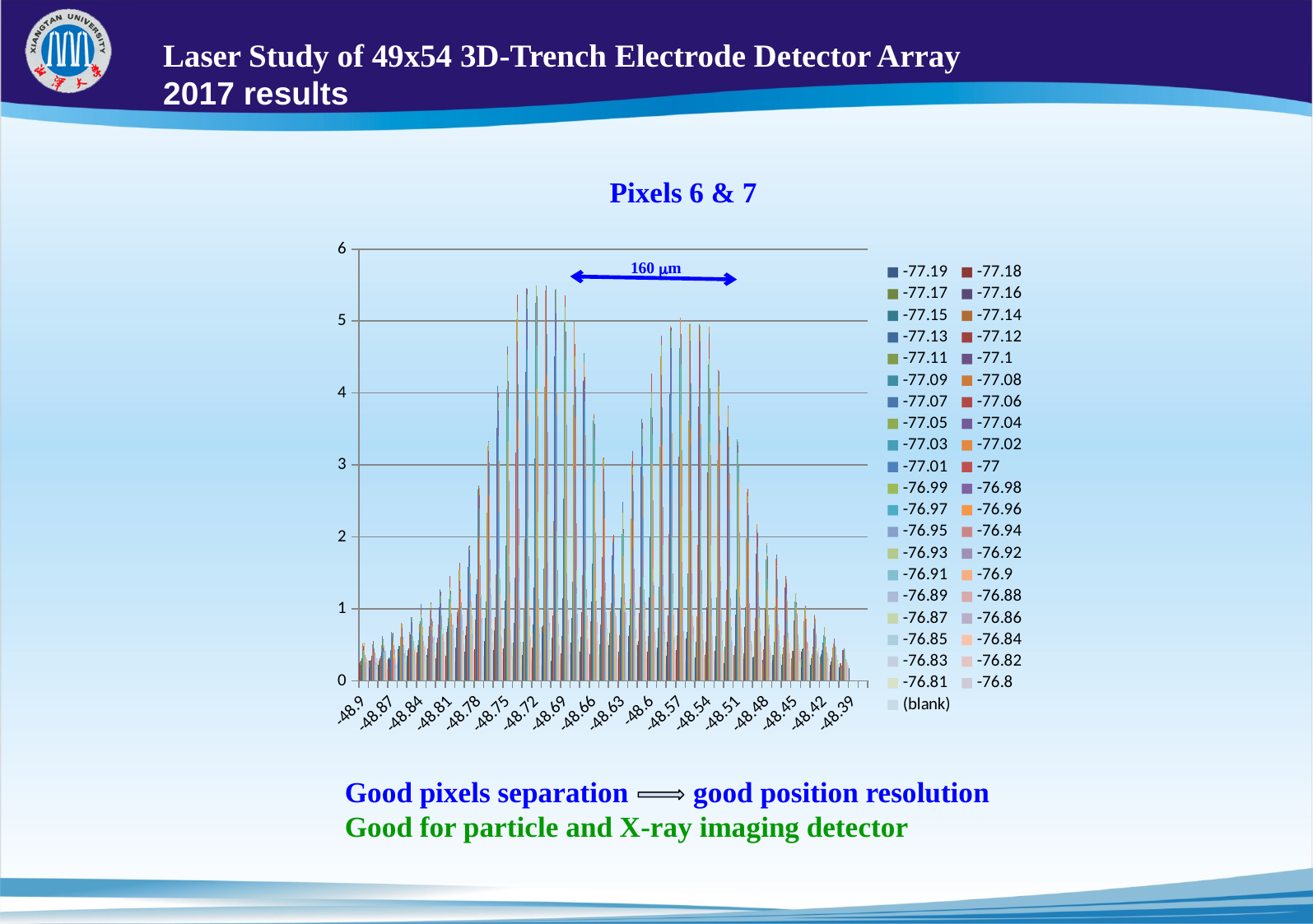
Are the tallest bars near the -48.72 label greater or less than 5? greater Are the bars at the -48.9 label greater or less than 1? less What is the first (leftmost) category label on the chart's horizontal axis? -48.9 What kind of chart is shown on the slide? bar chart What is the last (rightmost) category label on the chart's horizontal axis? -48.39 How many distinct peaks do the bars form across the horizontal axis? 2 What is the title shown above the chart? Pixels 6 & 7 What is the highest value shown on the chart's vertical axis? 6 Which peak is taller: the one near -48.72 or the one near -48.57? the one near -48.72 How many series does the chart's legend list, including the (blank) entry? 41 What separation distance is annotated by the blue arrow between the two peaks? 160 μm Are the tallest bars near the -48.57 label greater or less than 4? greater